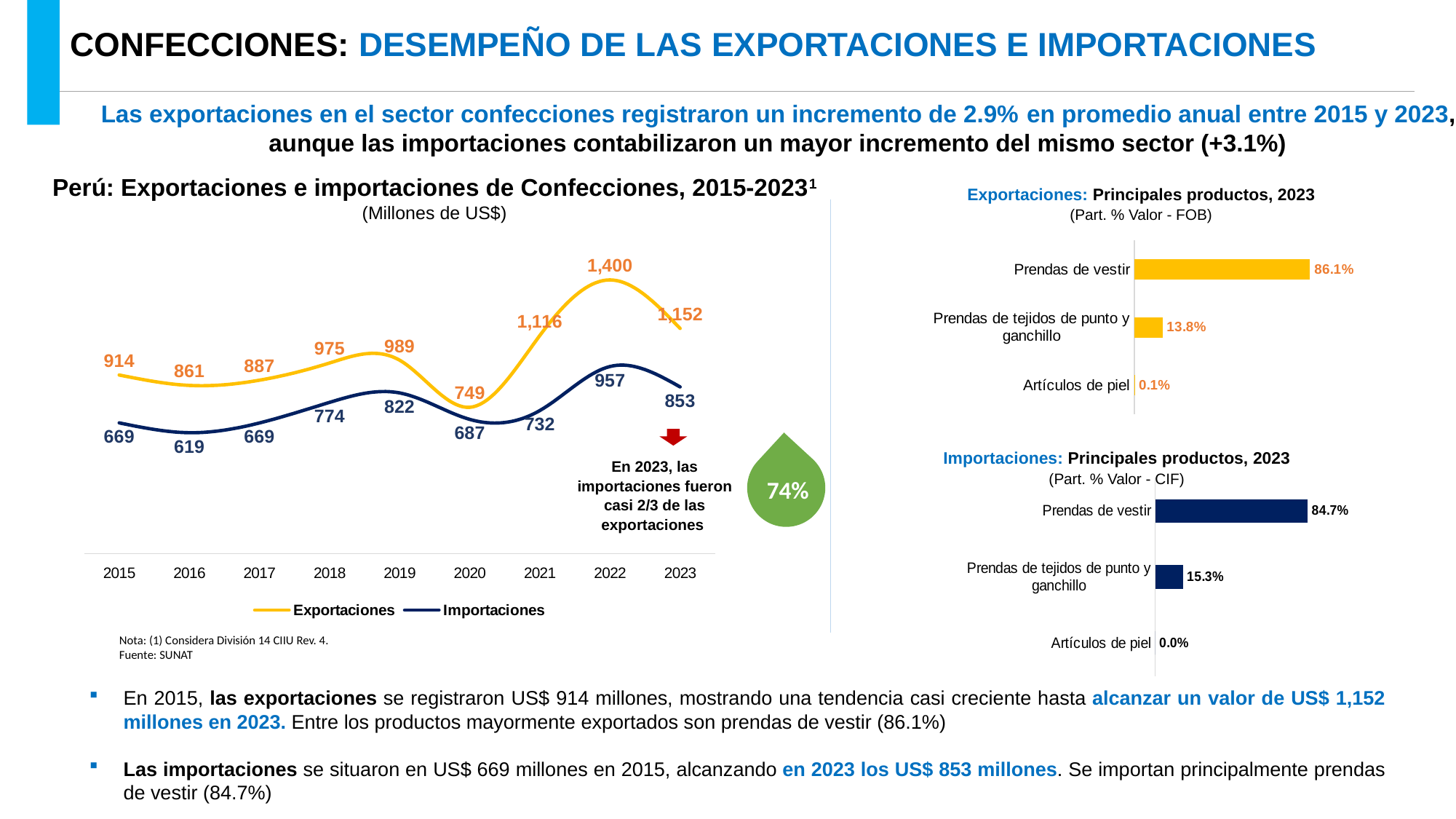
In the chart 'Perú: Exportaciones e importaciones de Confecciones, 2015-2023', what was the value of Exportaciones in 2022? 1,400 In the chart 'Importaciones: Principales productos, 2023', which product has the highest share? Prendas de vestir In the chart 'Perú: Exportaciones e importaciones de Confecciones, 2015-2023', what was the value of Importaciones in 2016? 619 In the chart 'Perú: Exportaciones e importaciones de Confecciones, 2015-2023', what is the difference between Exportaciones and Importaciones in 2023? 299 What kind of chart is 'Perú: Exportaciones e importaciones de Confecciones, 2015-2023'? Line chart In the chart 'Perú: Exportaciones e importaciones de Confecciones, 2015-2023', which year had the lowest value for Importaciones? 2016 In the chart 'Perú: Exportaciones e importaciones de Confecciones, 2015-2023', which year had the highest value for Exportaciones? 2022 In the chart 'Perú: Exportaciones e importaciones de Confecciones, 2015-2023', how many years are shown on the x axis? 9 In the chart 'Perú: Exportaciones e importaciones de Confecciones, 2015-2023', which was larger in 2020: Exportaciones or Importaciones? Exportaciones What kind of chart is 'Importaciones: Principales productos, 2023'? Bar chart In the chart 'Exportaciones: Principales productos, 2023', what is the share for Prendas de tejidos de punto y ganchillo? 13.8% In the chart 'Perú: Exportaciones e importaciones de Confecciones, 2015-2023', how many series does the legend list? 2